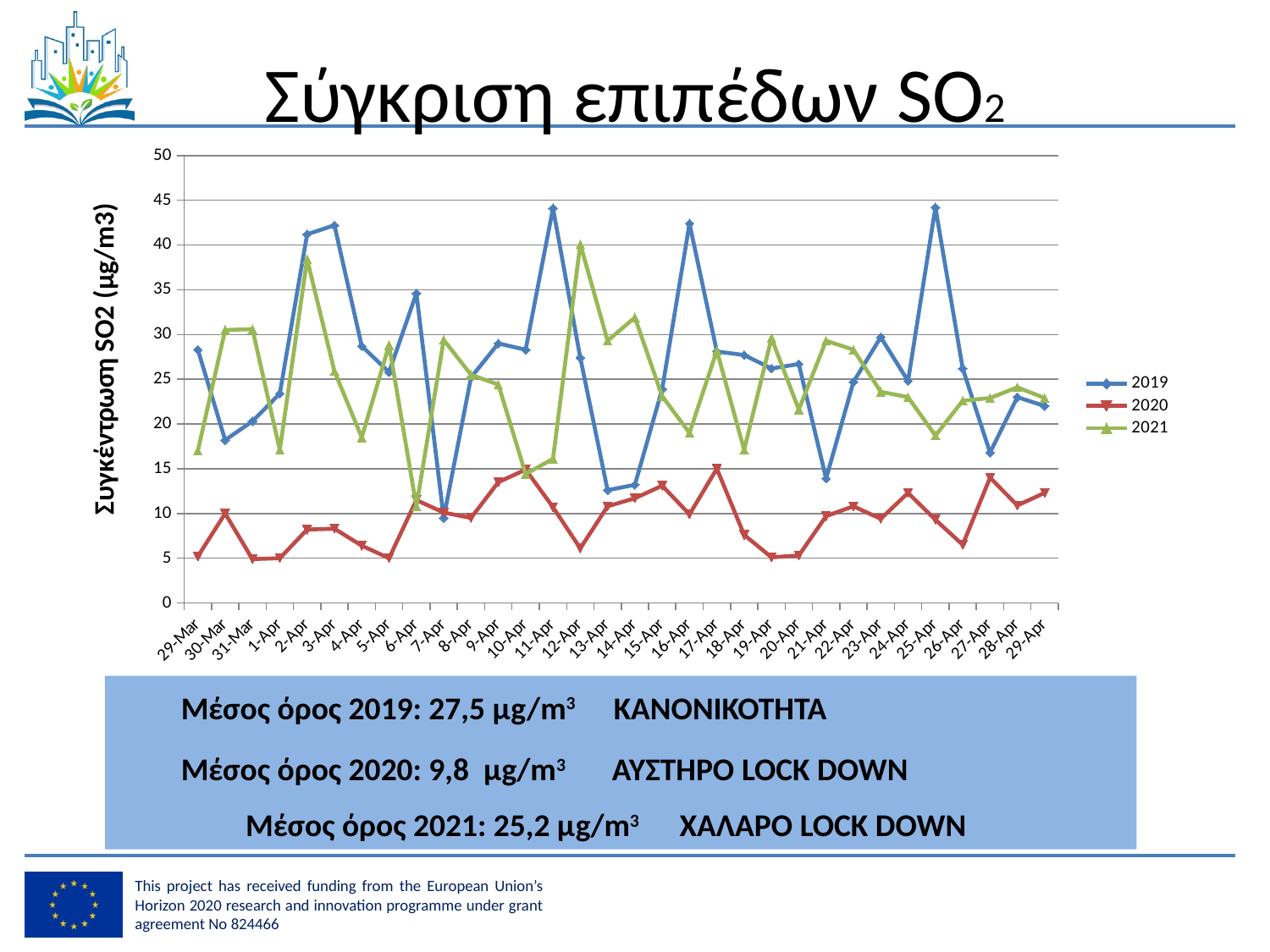
Is the value for the 2020 series on 29-Mar greater or less than 10? less On 2-Apr, which series has the larger value, 2021 or 2020? 2021 Is the value for the 2019 series on 11-Apr greater or less than 40? greater What kind of chart is shown on the slide? line chart Is the value for the 2019 series on 7-Apr greater or less than 15? less How many dates are shown along the x axis of the chart? 32 Which series are listed in the chart legend? 2019, 2020, 2021 How many series does the chart legend list? 3 What is the label of the vertical axis of the chart? Συγκέντρωση SO2 (μg/m3) On 11-Apr, which series has the larger value, 2019 or 2020? 2019